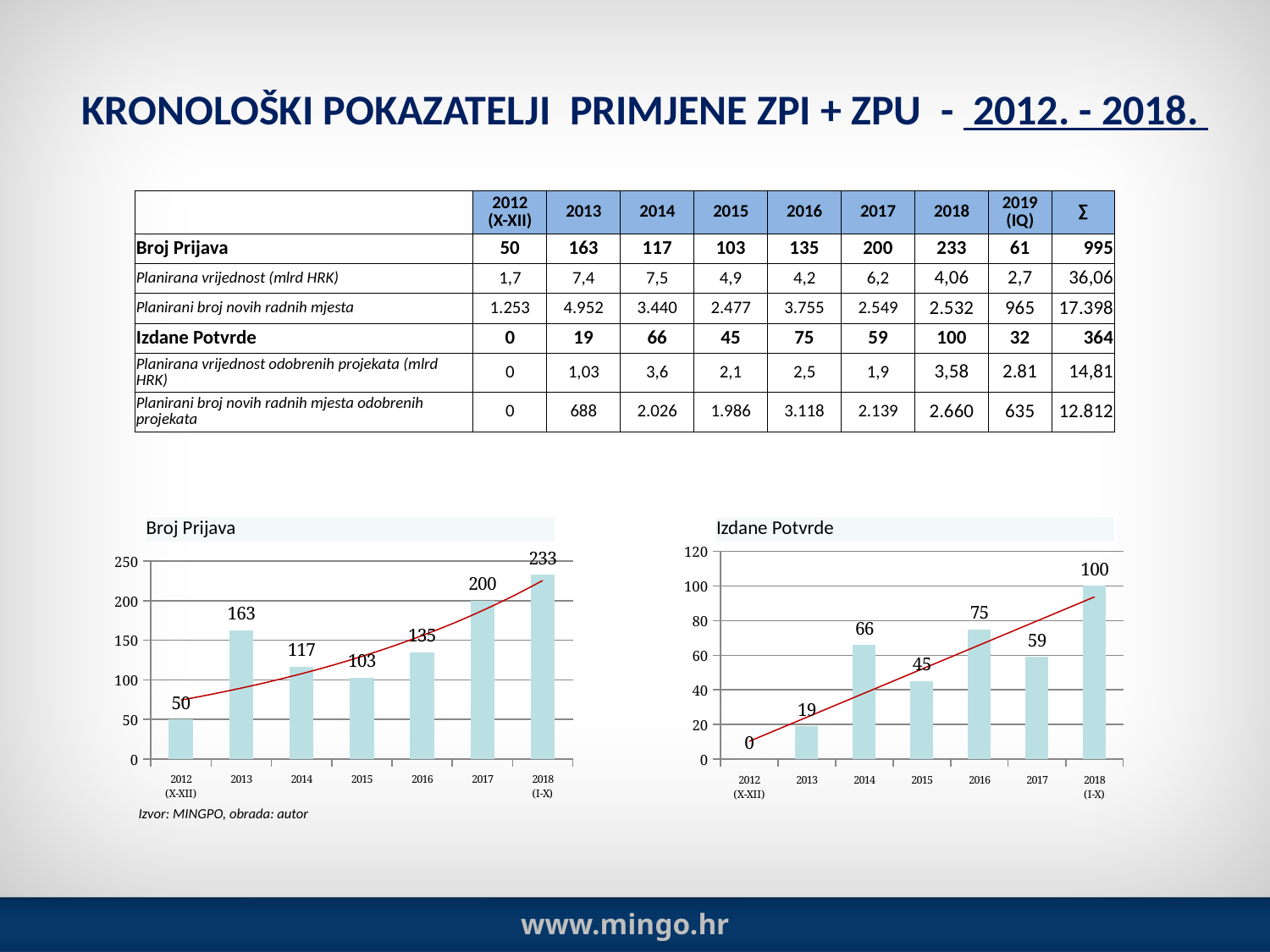
In the 'Izdane Potvrde' chart, which year has the highest value? 2018 In the 'Broj Prijava' chart, do the values generally rise or fall from 2015 to 2018? Rise In the 'Broj Prijava' chart, which year has the lowest value? 2012 In the 'Izdane Potvrde' chart, is the value for 2013 greater or less than 20? less In the 'Broj Prijava' chart, what is the difference between the values for 2018 and 2017? 33 In the 'Broj Prijava' chart, which year has the highest value? 2018 In the 'Izdane Potvrde' chart, what is the value for 2016? 75 In the 'Broj Prijava' chart, how many bars are plotted? 7 In the 'Izdane Potvrde' chart, what is the difference between the values for 2014 and 2015? 21 In the 'Broj Prijava' chart, what is the value for 2013? 163 In the 'Izdane Potvrde' chart, which is larger, the value for 2014 or the value for 2017? 2014 What kind of chart is the 'Izdane Potvrde' chart? Bar chart